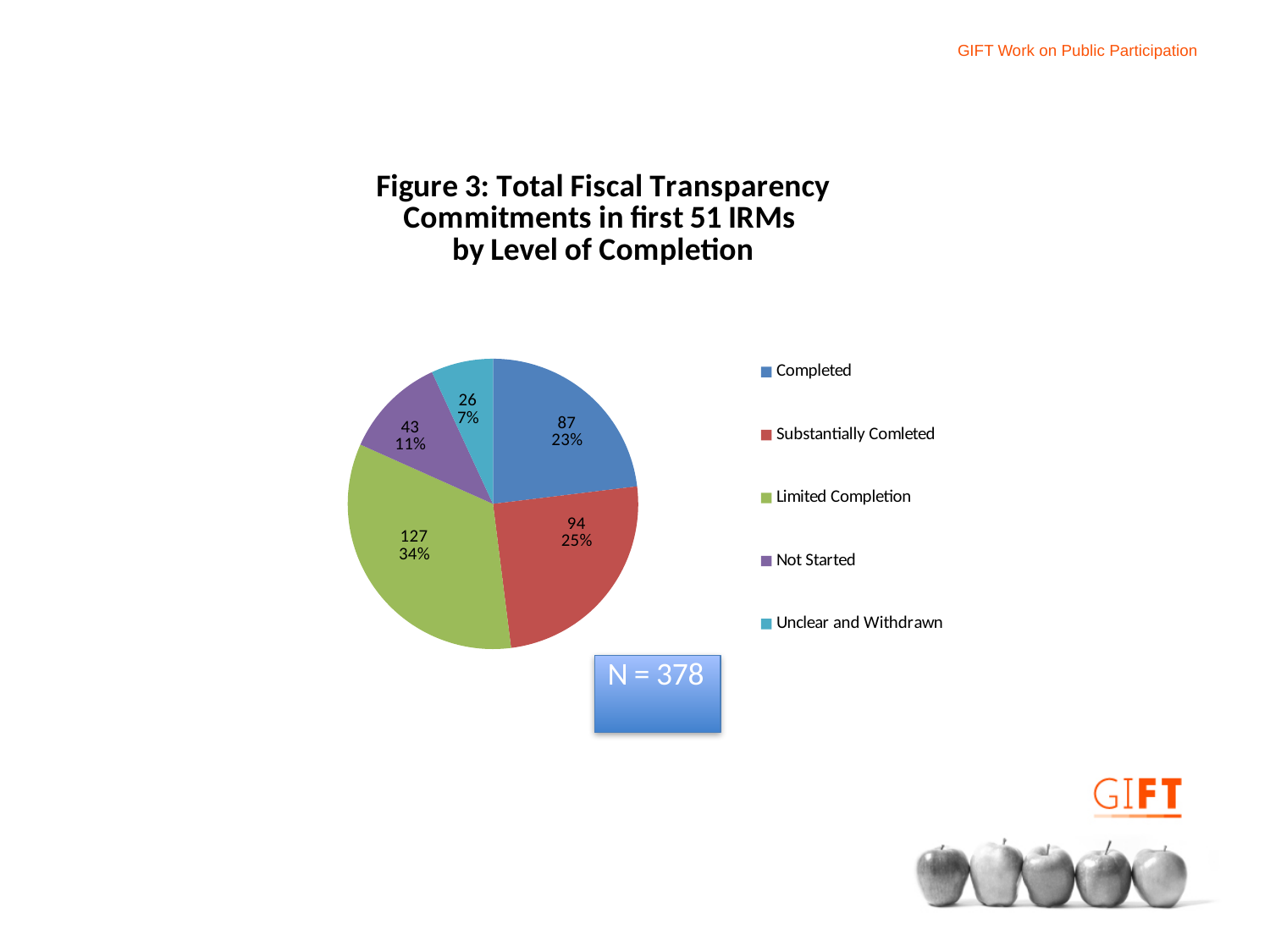
Which category has the smallest share of the pie? Unclear and Withdrawn How many commitments are Unclear and Withdrawn? 26 How many commitments are labelled as Completed? 87 What percentage of commitments are Substantially Comleted? 25% What total N is shown below the pie chart? N = 378 Which category has the largest share of the pie? Limited Completion What is the difference in count between Limited Completion and Completed? 40 Which is larger, the Substantially Comleted slice or the Completed slice? Substantially Comleted How many categories does the legend list? 5 What kind of chart is shown on the slide? pie chart How many commitments fall under Limited Completion? 127 What percentage of commitments are Not Started? 11%